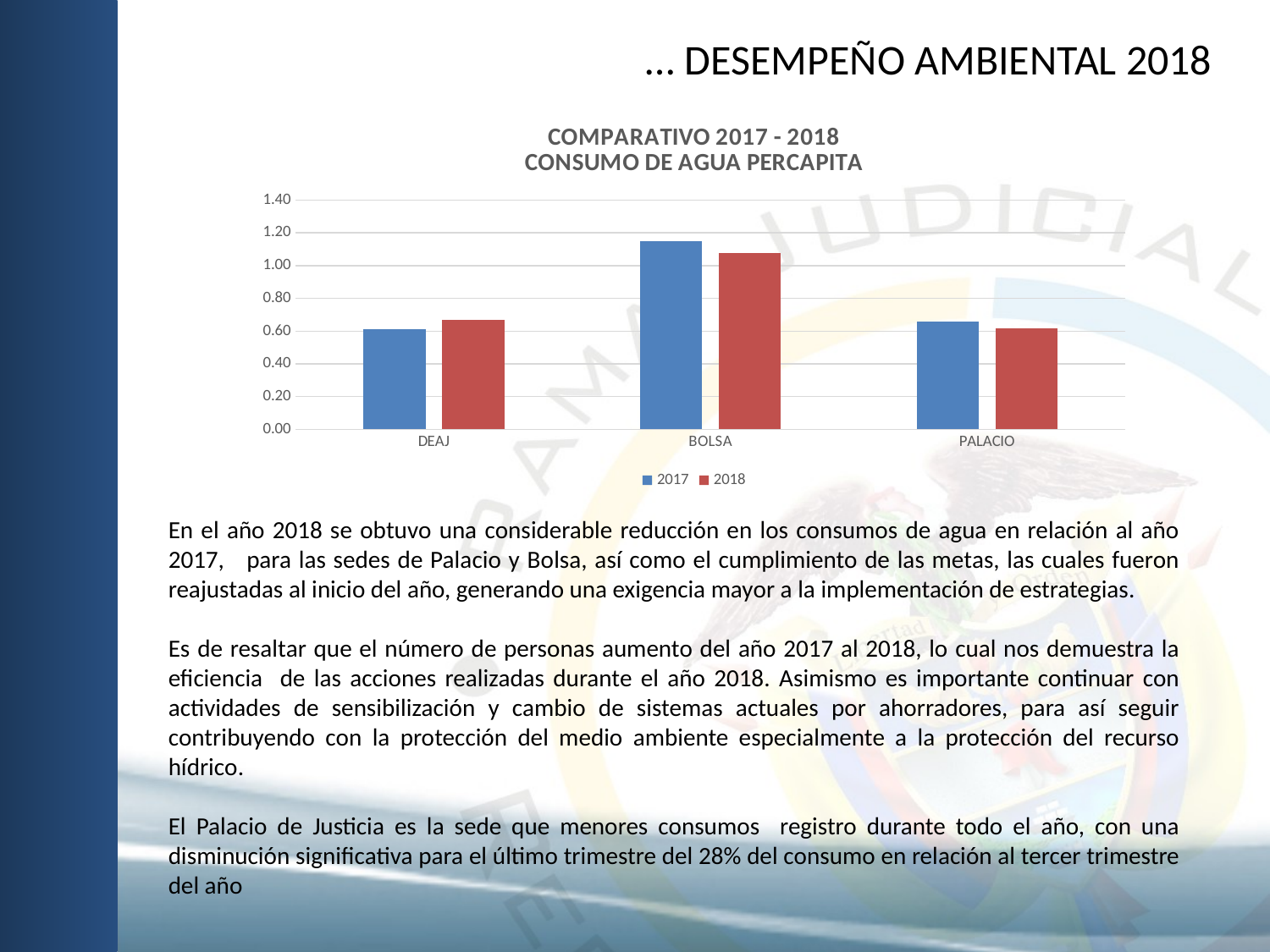
How many series does the chart legend list? 2 Is the 2018 value for PALACIO greater or less than 0.40? greater What is the title of the chart? COMPARATIVO 2017 - 2018 CONSUMO DE AGUA PERCAPITA Which colour represents the 2018 series in the chart? red Is the 2017 value for BOLSA greater or less than 1.00? greater What kind of chart is shown on the slide? bar chart For DEAJ, which is larger: the 2017 value or the 2018 value? 2018 Which category has the highest value for the 2018 series? BOLSA Which category has the highest value for the 2017 series? BOLSA For BOLSA, which is larger: the 2017 value or the 2018 value? 2017 Is the 2018 value for DEAJ greater or less than 0.80? less How many categories are shown on the x axis of the chart? 3